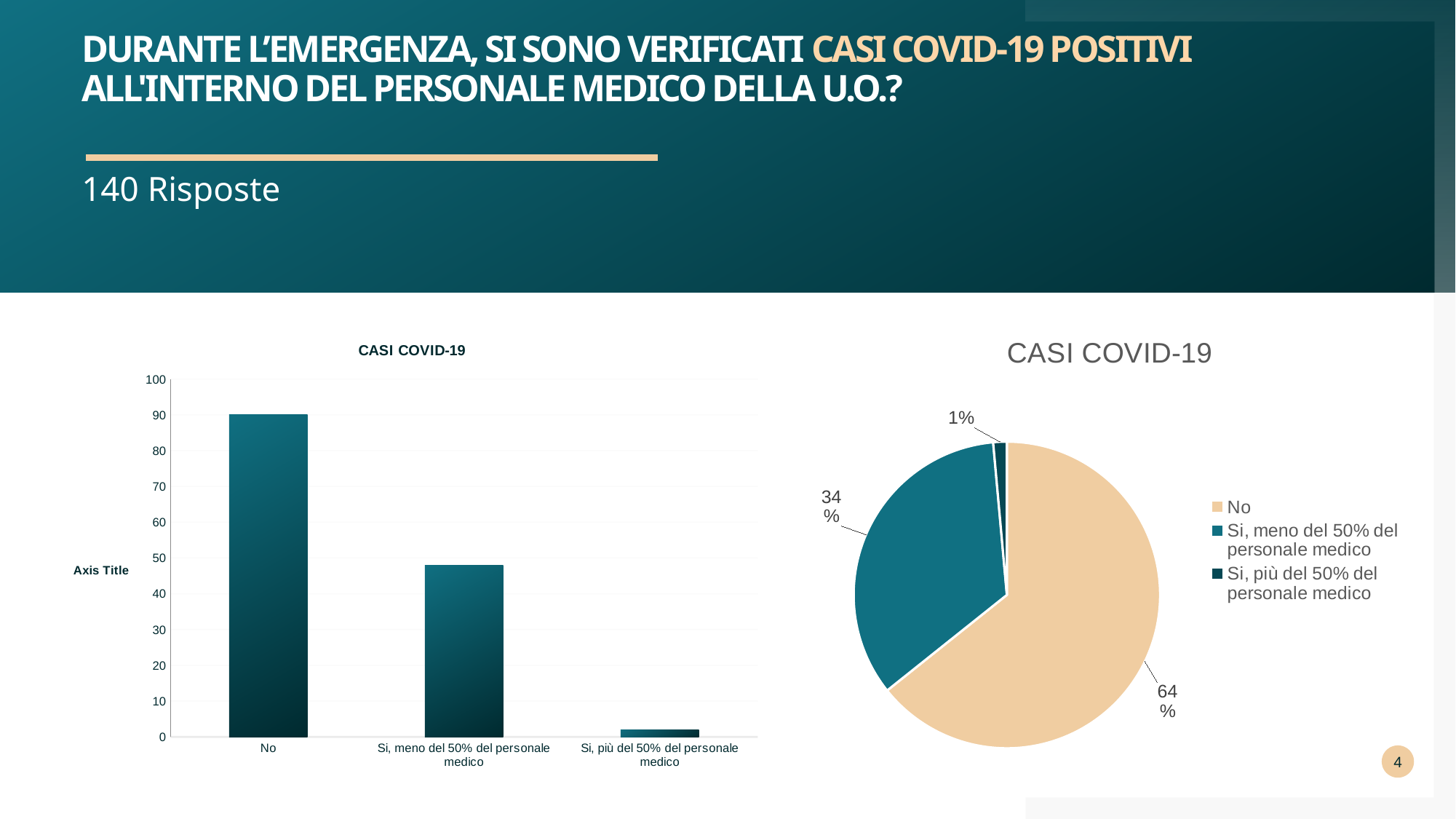
On the pie chart on the right, how many entries does the legend list? 3 On the bar chart on the left, what is the value for "No"? 90 What kind of chart is the chart on the left of the slide? bar chart On the pie chart on the right, what share does "No" have? 64% On the bar chart on the left, which category has the lowest value? Si, più del 50% del personale medico On the bar chart on the left, is the value for "Si, meno del 50% del personale medico" greater or less than 40? greater On the bar chart on the left, which category has the highest value? No On the pie chart on the right, what share does "Si, meno del 50% del personale medico" have? 34% On the bar chart on the left, how many categories are shown on the x axis? 3 On the pie chart on the right, what is the difference between the share for "No" and the share for "Si, meno del 50% del personale medico"? 30% What is the title of the pie chart on the right? CASI COVID-19 On the bar chart on the left, is the value for "Si, più del 50% del personale medico" greater or less than 10? less